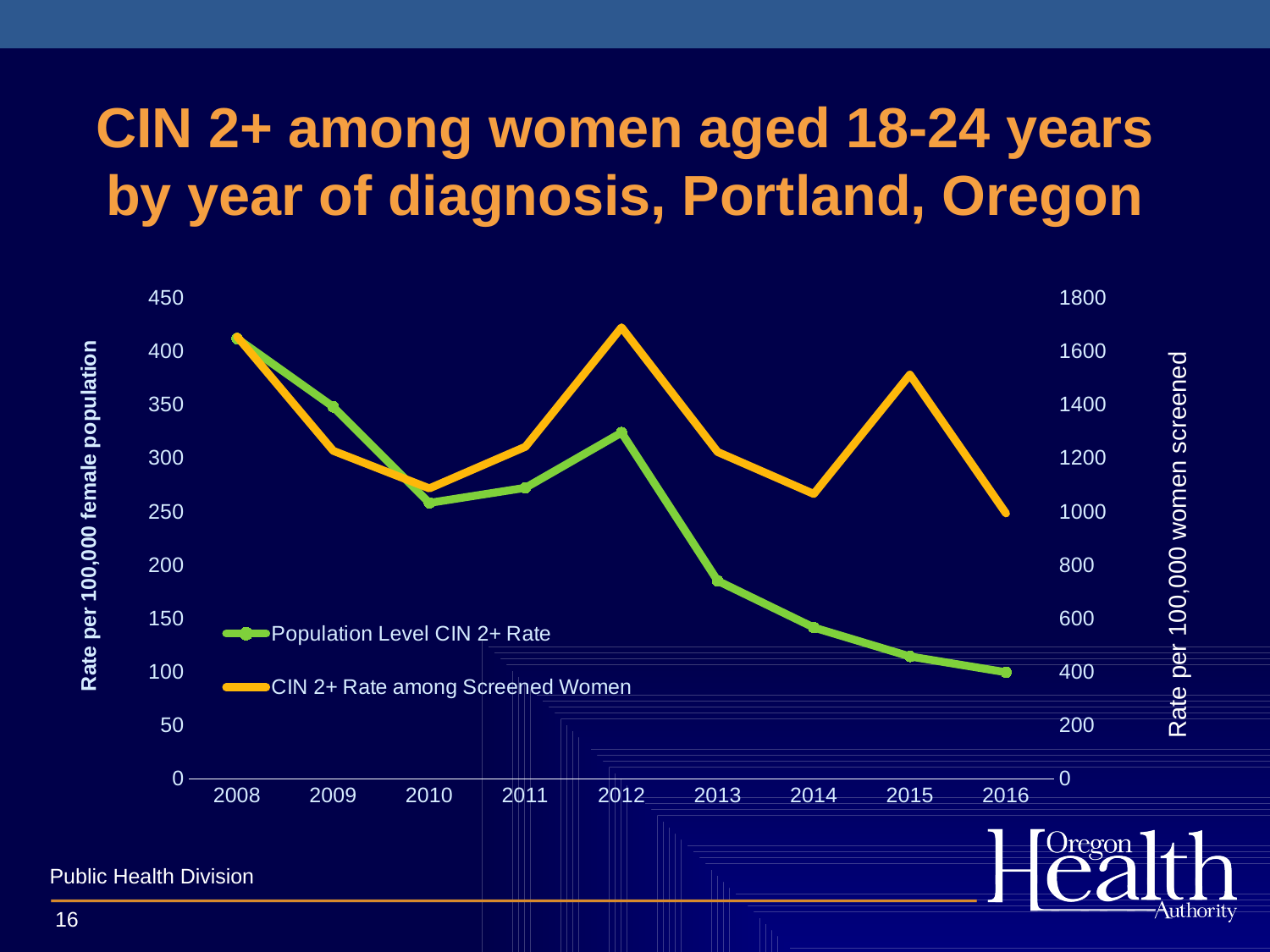
How many series does the legend list? 2 Is the Population Level CIN 2+ Rate in 2013 greater or less than 200? less What kind of chart is shown on the slide? line chart In which year is the CIN 2+ Rate among Screened Women highest? 2012 How many years are plotted along the x axis? 9 Which is larger, the Population Level CIN 2+ Rate in 2009 or in 2013? 2009 What is the label on the left vertical axis? Rate per 100,000 female population Does the Population Level CIN 2+ Rate overall rise or fall from 2008 to 2016? fall Is the Population Level CIN 2+ Rate in 2012 greater or less than 300? greater In which year is the Population Level CIN 2+ Rate lowest? 2016 In which year is the Population Level CIN 2+ Rate highest? 2008 Is the CIN 2+ Rate among Screened Women in 2016 greater or less than 1200? less